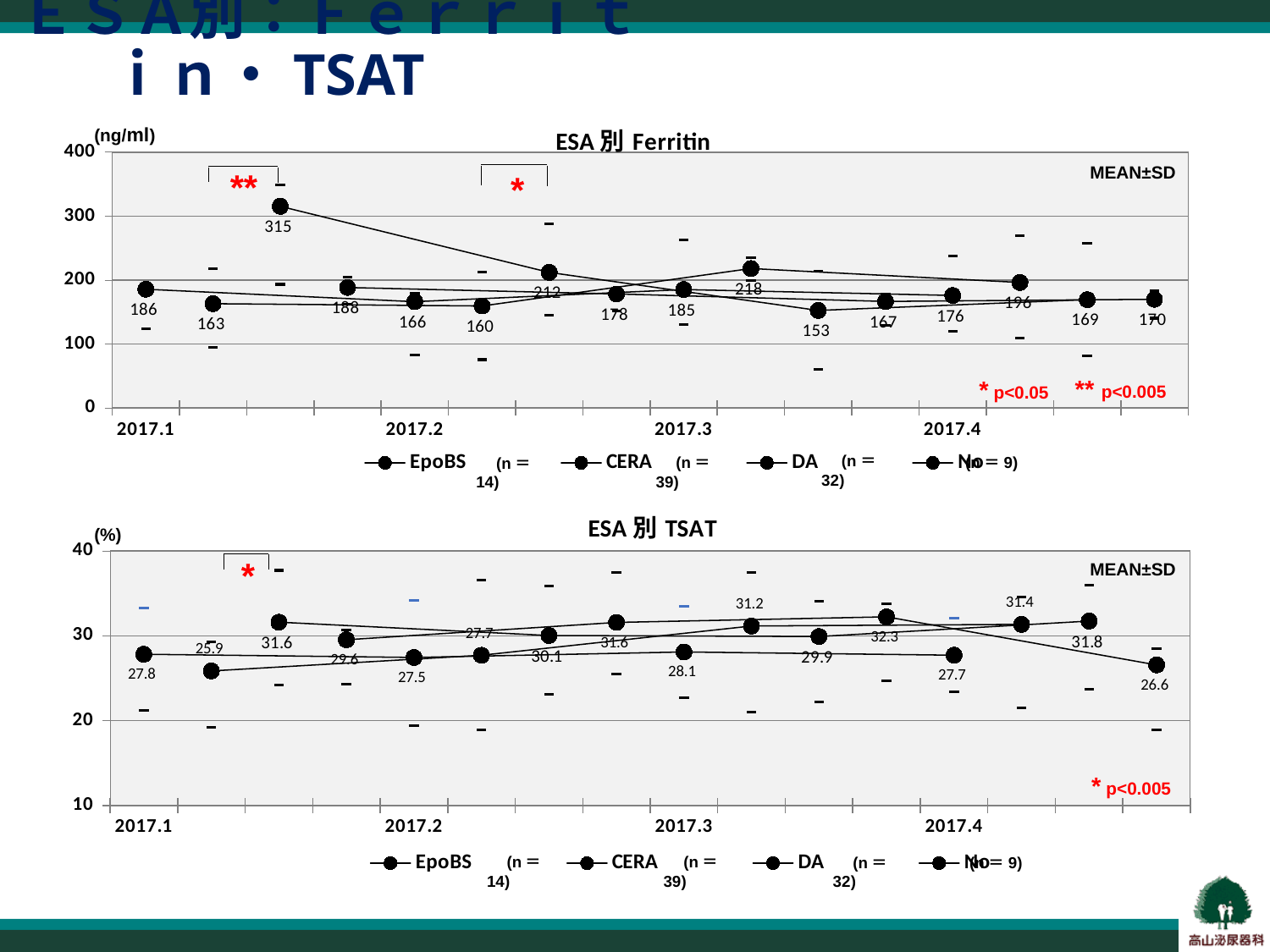
How many time-period labels are shown on the x axis of the 'ESA 別 TSAT' chart? 4 In the 'ESA 別 TSAT' chart, which labelled value is larger, 31.2 or 29.9? 31.2 In the 'ESA 別 Ferritin' chart, what is the difference between the highest labelled value (315) and the lowest labelled value (153)? 162 According to the legend of the 'ESA 別 Ferritin' chart, what is the n for the CERA series? 39 In the 'ESA 別 TSAT' chart, what is the lowest data label shown? 25.9 In the 'ESA 別 Ferritin' chart, what is the highest data label shown? 315 How many series does the legend of the 'ESA 別 TSAT' chart list? 4 In the 'ESA 別 Ferritin' chart, what is the lowest data label shown? 153 What kind of chart is the 'ESA 別 Ferritin' chart? line chart In the 'ESA 別 TSAT' chart, what is the highest data label shown? 32.3 What unit is shown on the y axis of the 'ESA 別 Ferritin' chart? (ng/ml) In the 'ESA 別 Ferritin' chart, is the highest plotted point greater or less than 300? greater